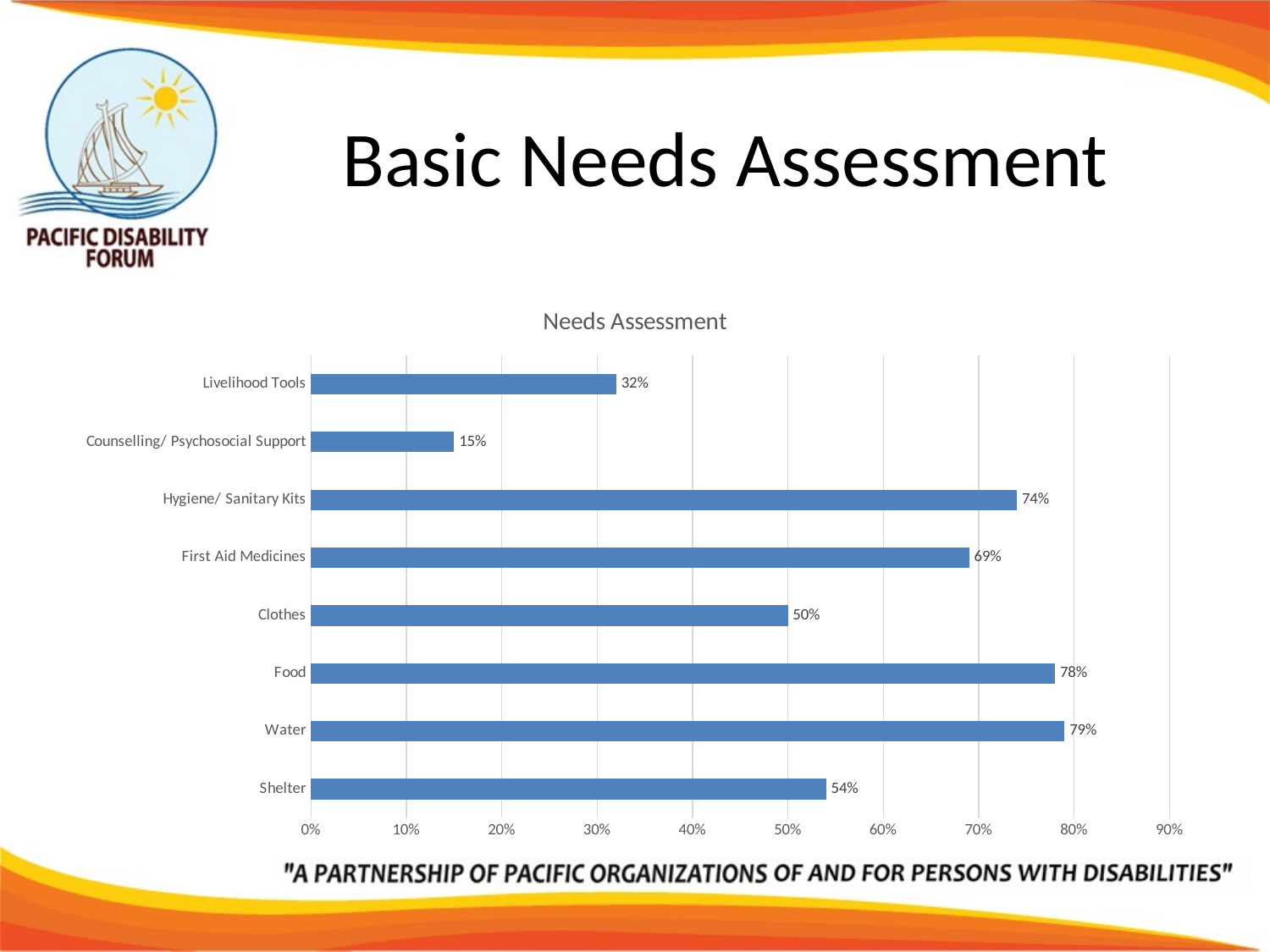
What is the value for Counselling/ Psychosocial Support? 15% What is the difference between the values for Water and Shelter? 25% Which is larger, the value for Shelter or the value for Livelihood Tools? Shelter How many categories are shown in the chart? 8 Which category has the lowest value? Counselling/ Psychosocial Support What kind of chart is shown on the slide? Bar chart What is the value for Water? 79% Is the value for First Aid Medicines greater or less than 60%? greater What is the value for Hygiene/ Sanitary Kits? 74% What is the difference between the values for Food and Clothes? 28% Which category has the highest value? Water What is the title of the chart? Needs Assessment